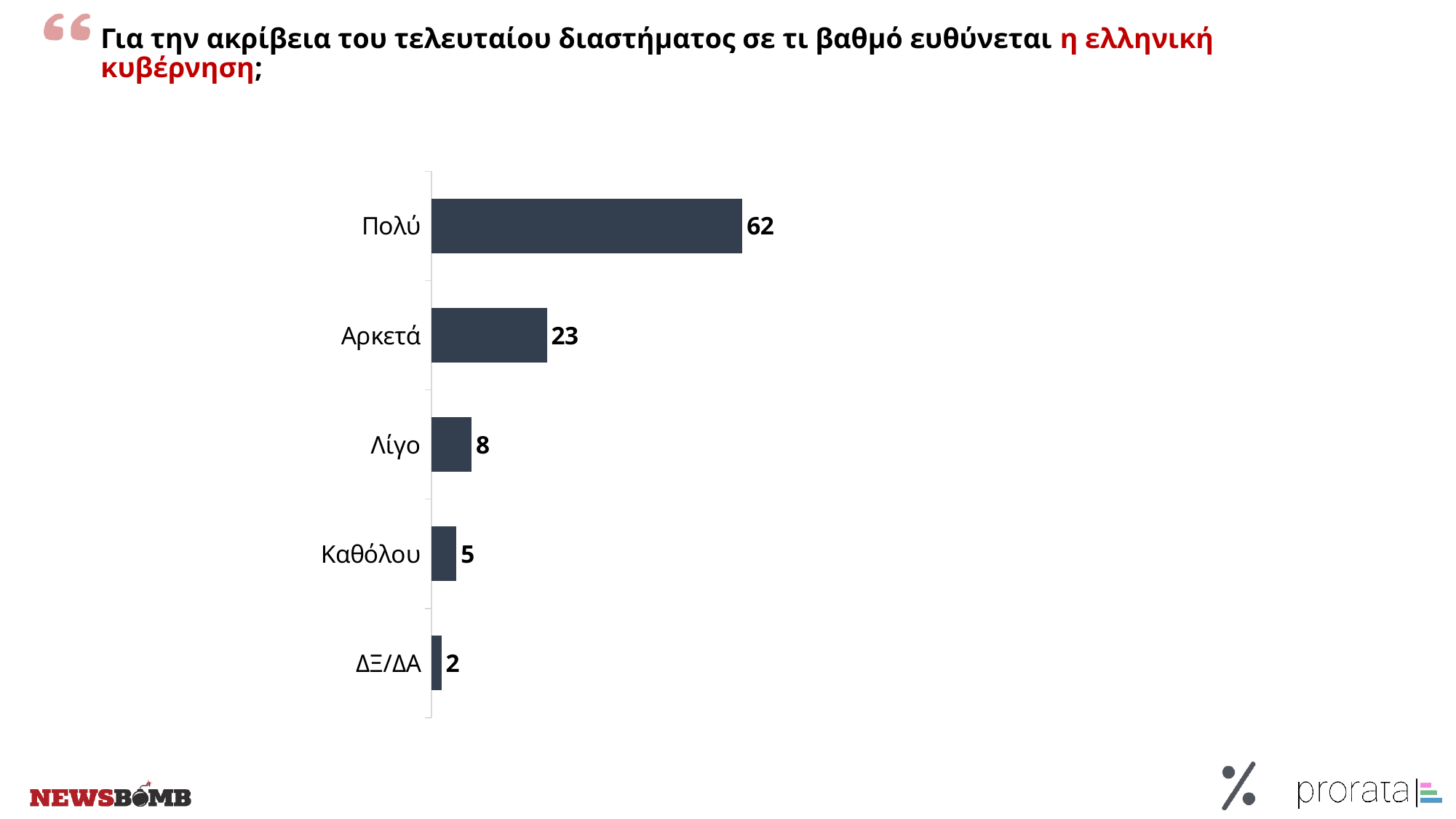
What is the value for Λίγο? 8 What is the value for Πολύ? 62 What is the value for ΔΞ/ΔΑ? 2 What is the value for Καθόλου? 5 What kind of chart is shown on the slide? Bar chart Which is larger, the value for Λίγο or the value for Καθόλου? Λίγο How many categories are shown in the chart? 5 Which category has the lowest value? ΔΞ/ΔΑ What is the difference between the values for Πολύ and Αρκετά? 39 What is the value for Αρκετά? 23 Which category has the highest value? Πολύ What is the difference between the values for Αρκετά and Λίγο? 15